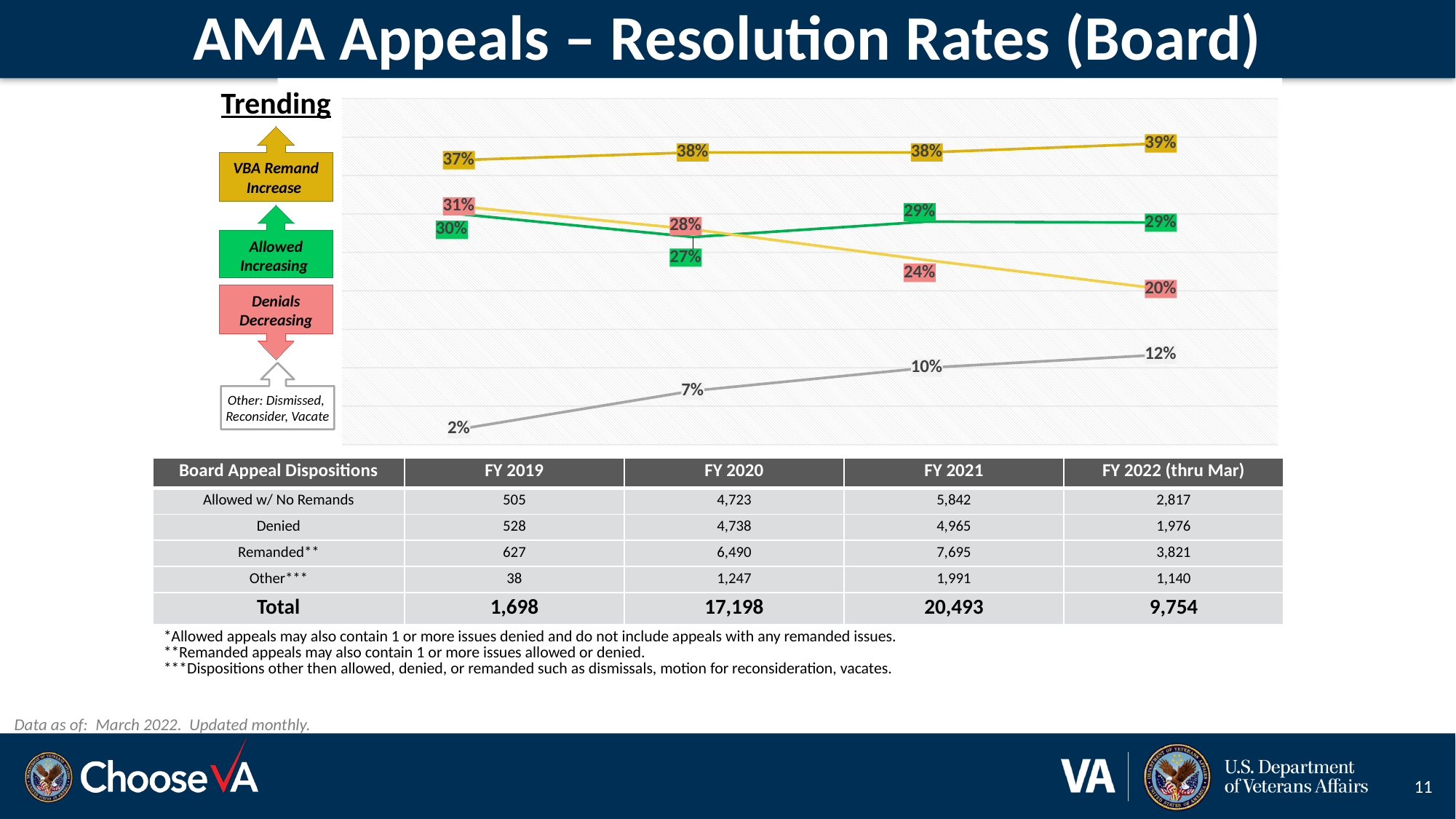
What is the value of the rightmost point on the gray Other line? 12% How many lines are plotted on the chart? 4 Which line has the lowest value at the leftmost point? Other What is the value of the leftmost point on the pink Denials line? 31% At the leftmost point, which is larger: the VBA Remand value or the Denials value? VBA Remand What is the value of the rightmost point on the gold VBA Remand line? 39% What is the value of the second point on the green Allowed line? 27% Does the pink Denials line rise or fall from left to right? fall What kind of chart is shown on the slide? line chart Which line has the highest value at the rightmost point? VBA Remand By how many percentage points does the Denials line fall from its first point (31%) to its last point (20%)? 11 percentage points How many data points does each line on the chart have? 4